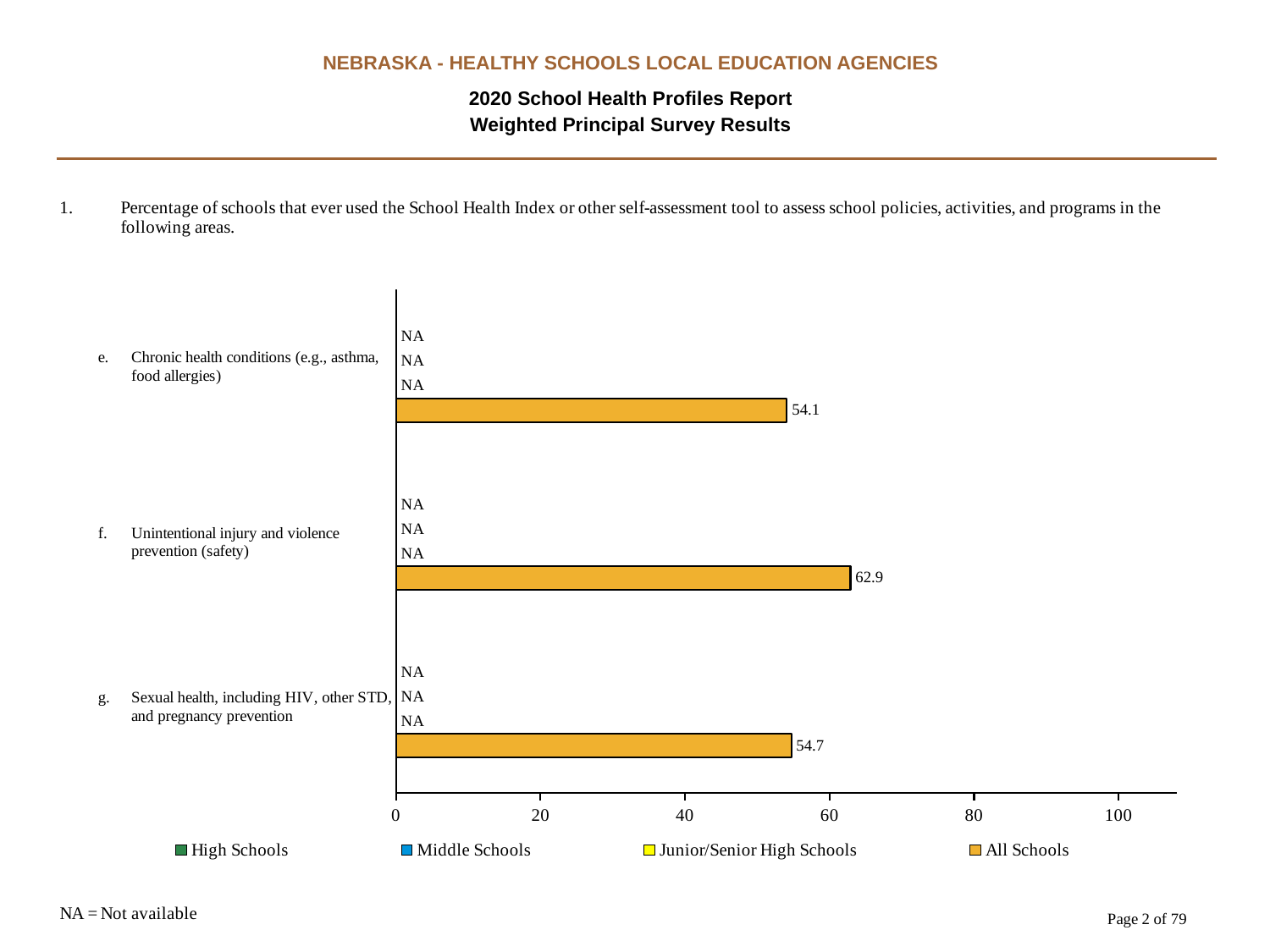
How many series does the legend list? 4 What kind of chart is shown on the slide? bar chart What value is shown for High Schools in the Chronic health conditions (e.g., asthma, food allergies) category? NA What is the difference between the All Schools values for Unintentional injury and violence prevention (safety) and Chronic health conditions (e.g., asthma, food allergies)? 8.8 What is the All Schools value for Sexual health, including HIV, other STD, and pregnancy prevention? 54.7 What is the All Schools value for Unintentional injury and violence prevention (safety)? 62.9 Which category has the lowest All Schools value? Chronic health conditions (e.g., asthma, food allergies) What does NA stand for according to the note on the slide? Not available Which category has the highest All Schools value? Unintentional injury and violence prevention (safety) Is the All Schools value for Unintentional injury and violence prevention (safety) greater or less than 60? greater How many categories are shown on the chart? 3 What is the All Schools value for Chronic health conditions (e.g., asthma, food allergies)? 54.1